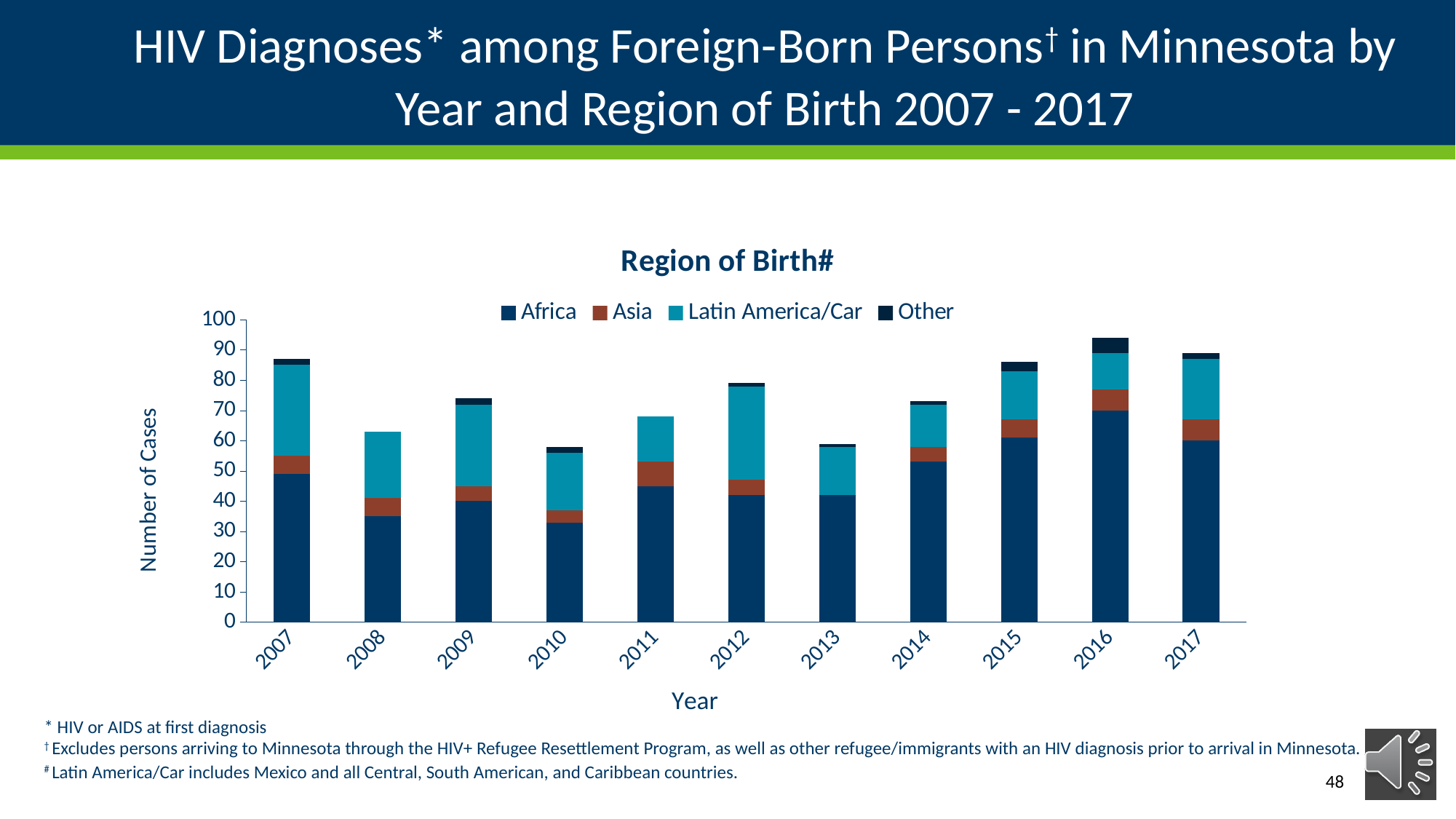
Do the total bars rise or fall from 2013 to 2016? rise Which year has the largest Africa segment? 2016 What is the title shown above the chart? Region of Birth# How many years are shown on the x axis? 11 Which year has the tallest total bar? 2016 What kind of chart is shown on the slide? stacked bar chart Is the total number of cases for 2016 greater or less than 90? greater Is the total number of cases for 2008 greater or less than 70? less Which year has the larger total bar, 2007 or 2008? 2007 Is the total number of cases for 2012 greater or less than 70? greater How many series does the legend list? 4